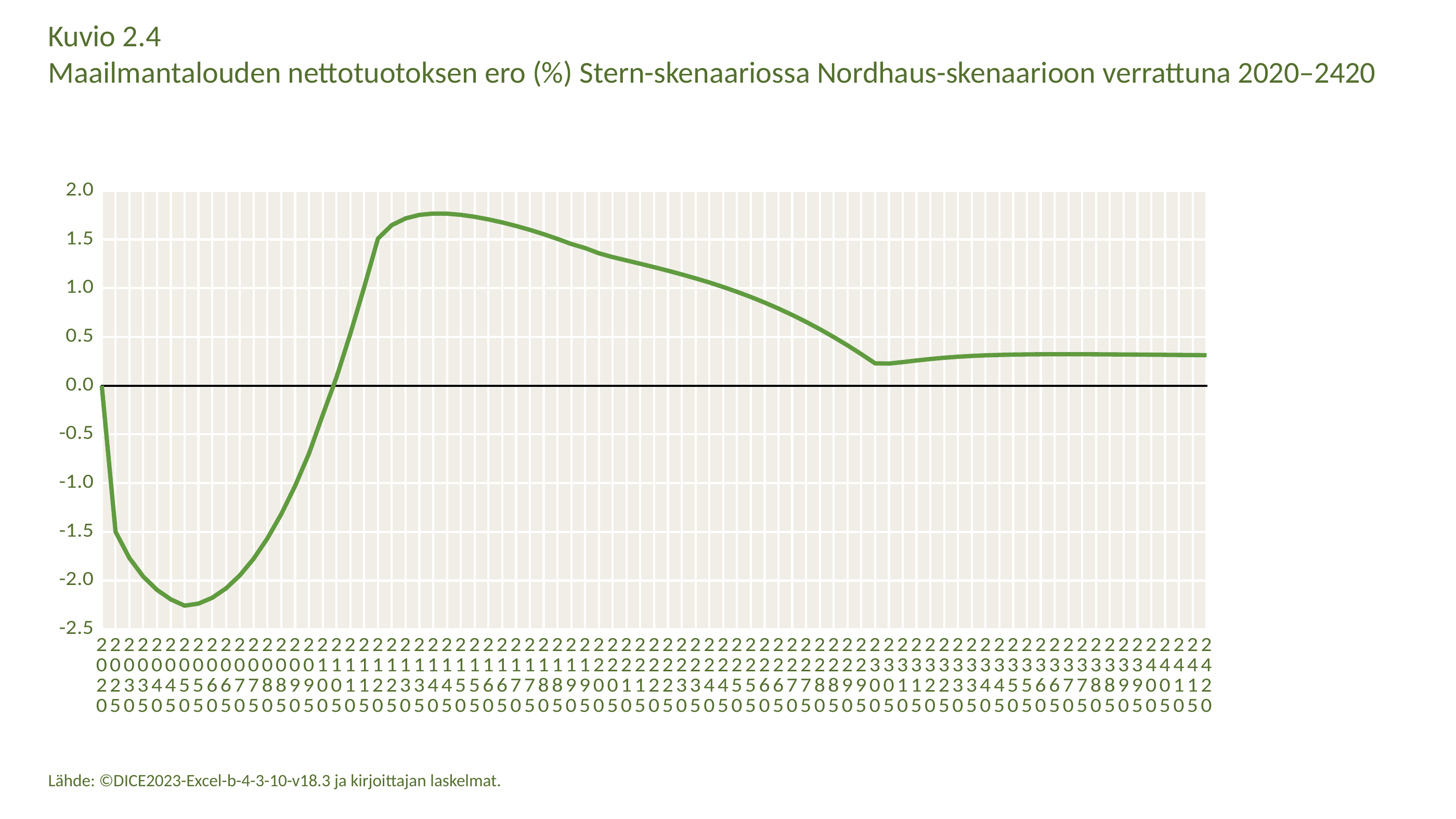
Is the value for 2200 greater or less than 1.0? greater Which is larger, the value for 2100 or the value for 2200? 2200 Does the line rise or fall between 2150 and 2300? fall Is the value for 2050 greater or less than -2.0? less What kind of chart is shown on the slide? line chart How many data points are plotted along the x axis (years 2020 to 2420 in 5-year steps)? 81 What colour is the plotted line? green Is the value for 2420 greater or less than 0.5? less What is the value of the line at 2020? 0.0 Does the line rise or fall between 2020 and 2050? fall What is the title of the chart? Maailmantalouden nettotuotoksen ero (%) Stern-skenaariossa Nordhaus-skenaarioon verrattuna 2020–2420